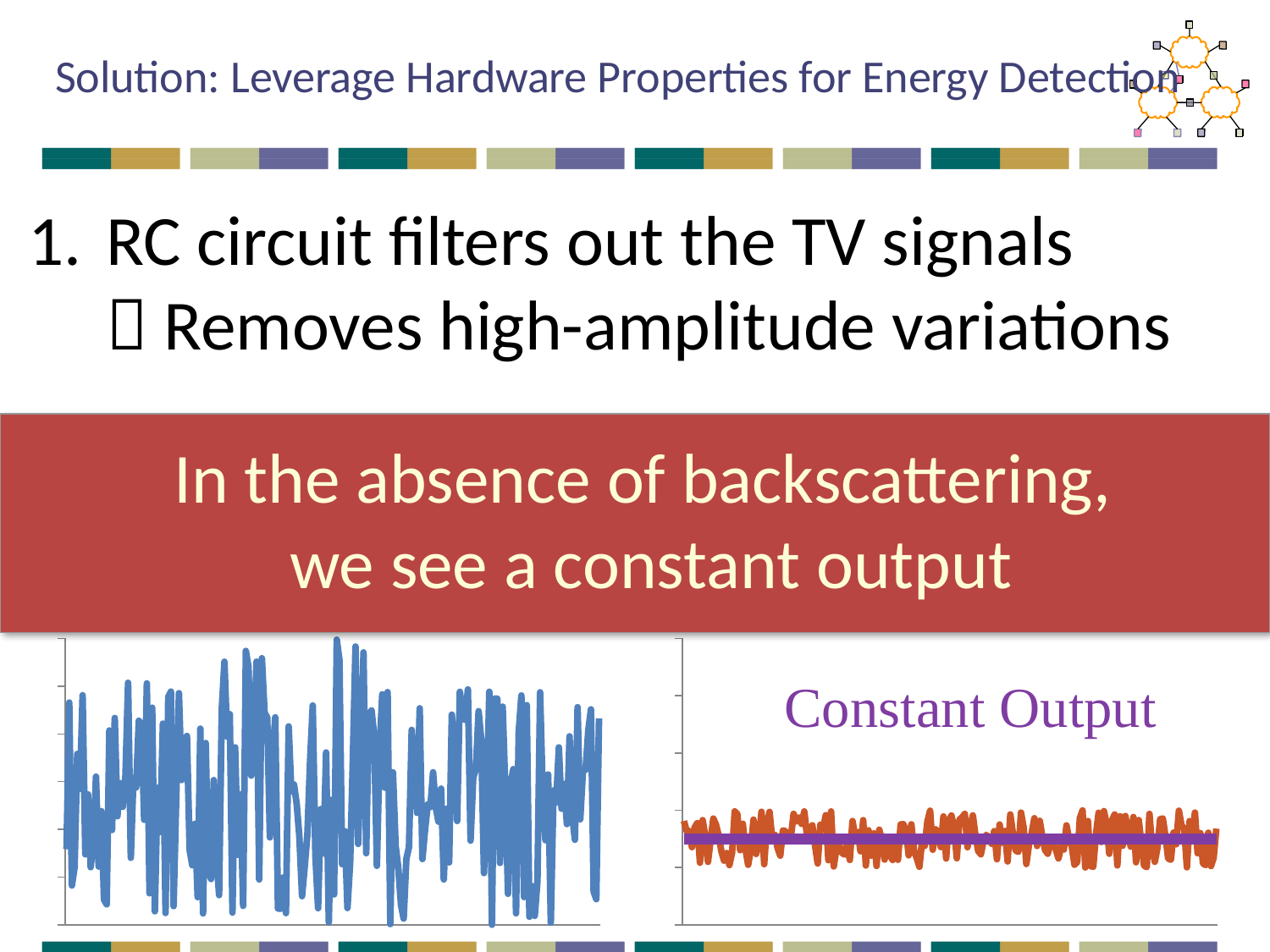
How many charts are shown on the slide? 2 On the right chart, does the plotted signal rise, fall, or stay roughly constant along the x axis? roughly constant What text label is printed on the right chart? Constant Output What kind of chart is the right chart on the slide? line chart Which chart shows larger amplitude variations in its signal, the left chart or the right chart? left chart What kind of chart is the left chart on the slide? line chart How many lines are drawn on the right chart? 2 What colour is the signal line in the left chart? blue